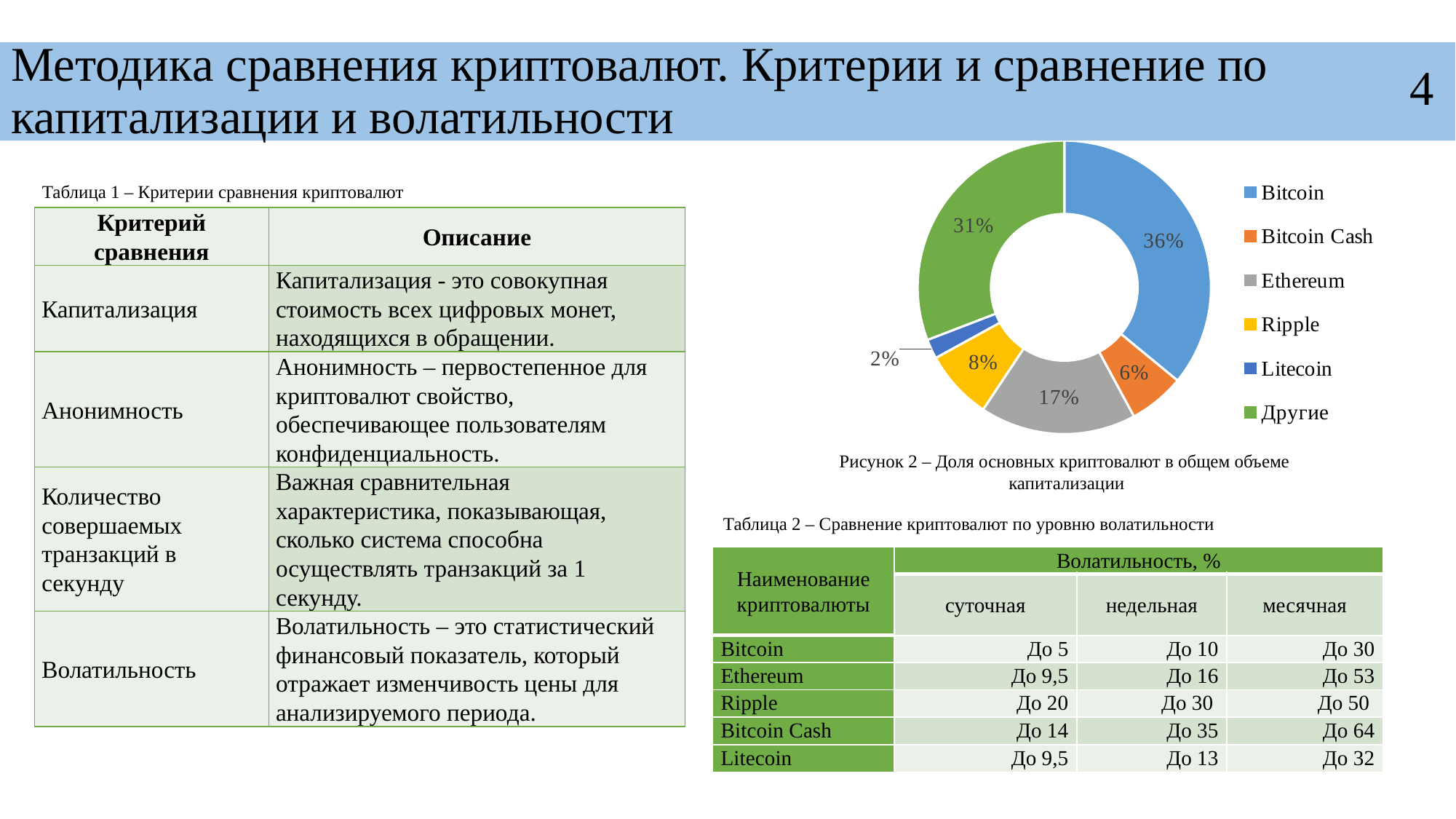
What colour represents Bitcoin in the doughnut chart? Blue Which category has the largest slice in the doughnut chart? Bitcoin What share does Ethereum hold in the doughnut chart? 17% What is the combined share of Bitcoin Cash and Ripple in the doughnut chart? 14% What type of chart is shown on the slide? Doughnut (pie) chart What share of total capitalization does Bitcoin hold in the doughnut chart? 36% Which category has the smallest slice in the doughnut chart? Litecoin Which slice is larger in the doughnut chart, Ripple or Bitcoin Cash? Ripple What is the difference in percentage points between the Bitcoin and Ethereum slices? 19 What share does Litecoin hold in the doughnut chart? 2% What share does the 'Другие' (Others) slice hold in the doughnut chart? 31% How many categories are shown in the doughnut chart? 6